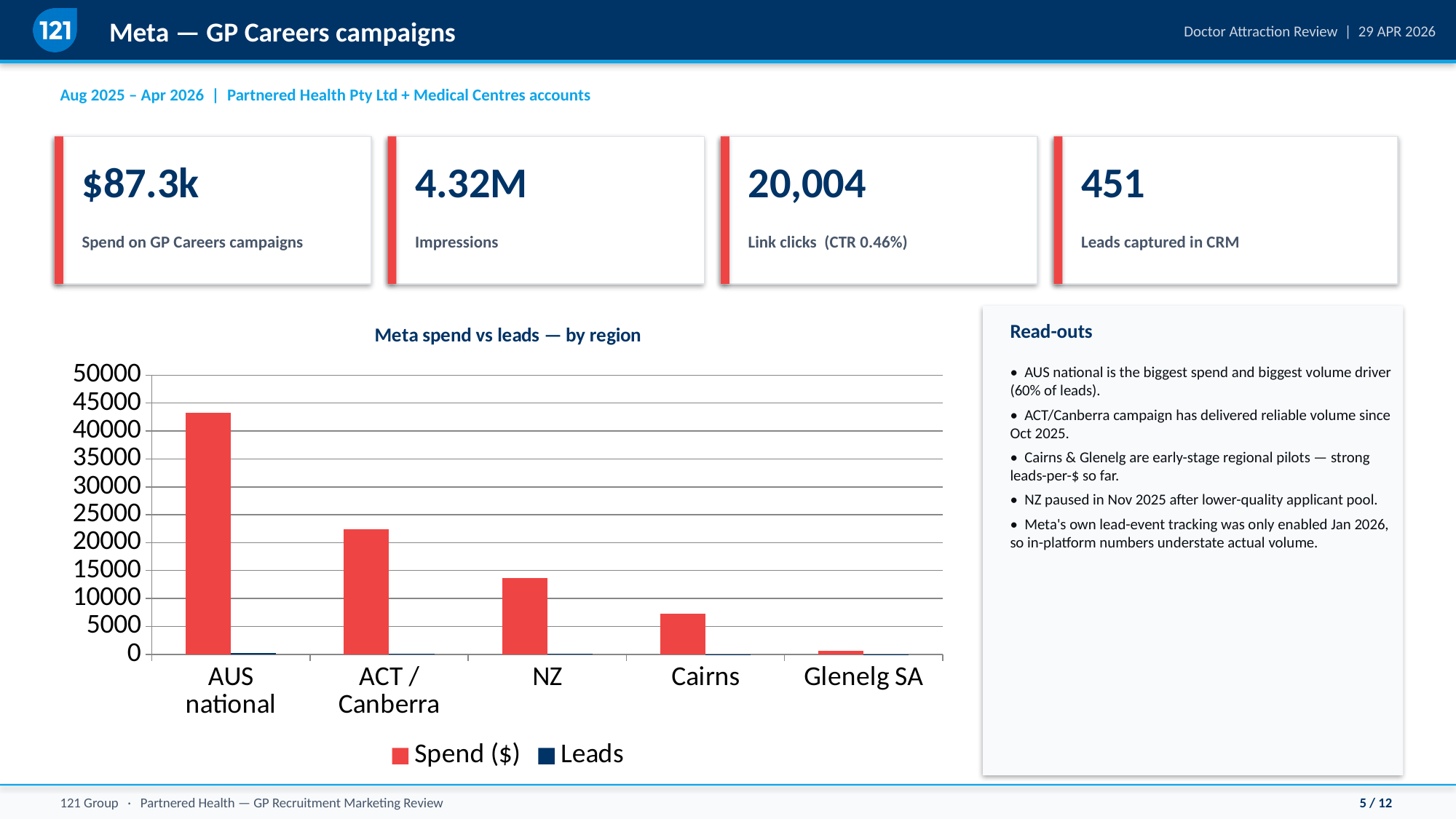
Which region has the larger Spend ($): ACT / Canberra or Cairns? ACT / Canberra What type of chart is shown on the slide? bar chart Do the Spend ($) values rise or fall moving from left to right along the x axis? fall How many series does the chart legend list? 2 Is the Spend ($) value for ACT / Canberra greater or less than 20000? greater Which region has the lowest Spend ($) in the chart? Glenelg SA Is the Spend ($) value for AUS national greater or less than 40000? greater Is the Spend ($) value for NZ greater or less than 15000? less How many regions are shown on the x axis of the chart? 5 What is the title of the chart on the slide? Meta spend vs leads — by region Which two series are listed in the chart legend? Spend ($) and Leads Which region has the highest Spend ($) in the chart? AUS national